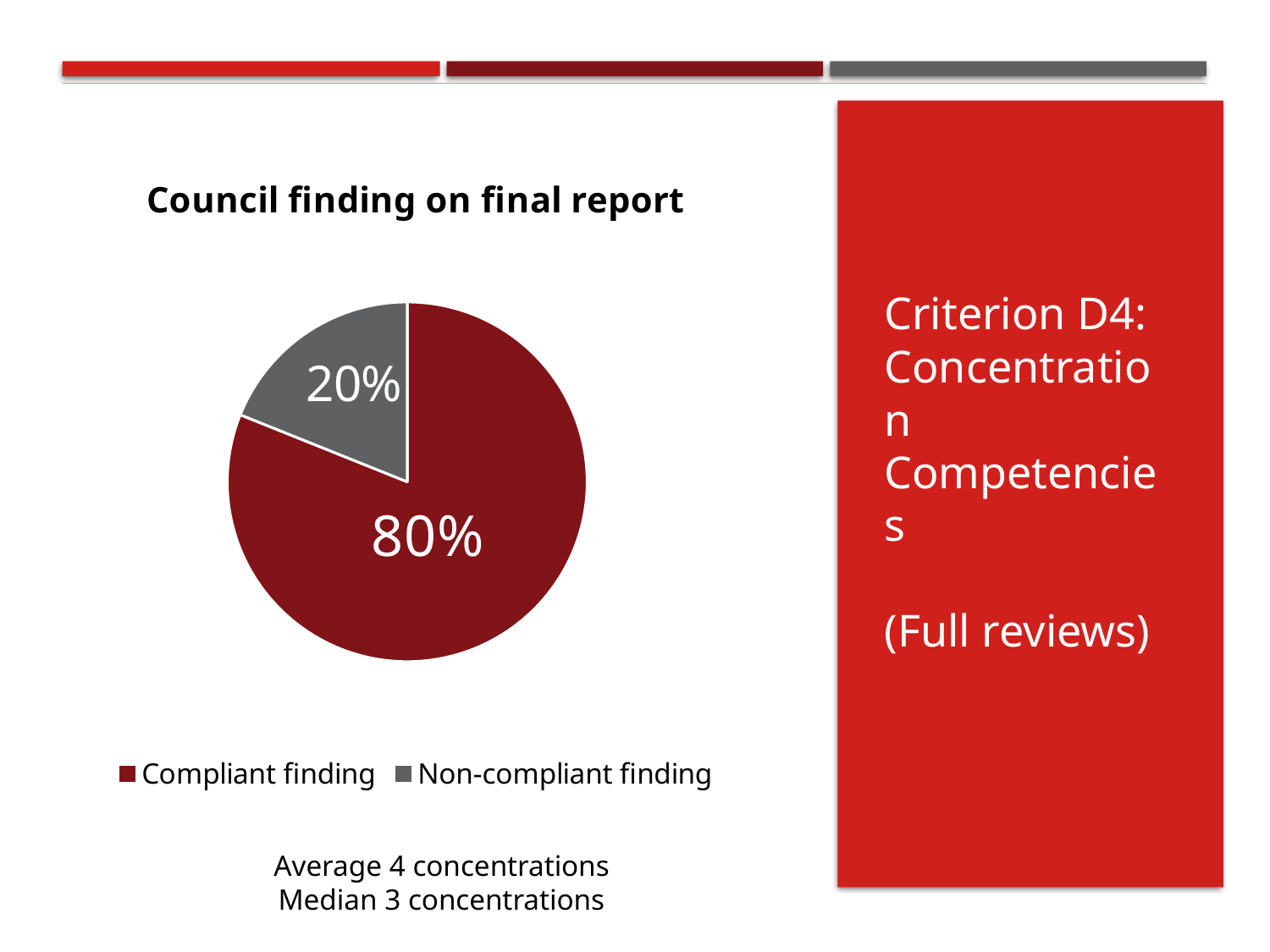
What kind of chart is shown on the slide? Pie chart Which slice is the smallest? Non-compliant finding What share of the pie is Compliant finding? 80% What is the difference in percentage points between Compliant finding and Non-compliant finding? 60 percentage points Which is larger, Compliant finding or Non-compliant finding? Compliant finding How many slices does the pie chart have? 2 What colour is the Non-compliant finding slice? Grey What share of the pie is Non-compliant finding? 20% How many entries does the legend list? 2 What is the chart's title? Council finding on final report Is the share for Compliant finding greater or less than 50%? greater Which slice is the largest? Compliant finding